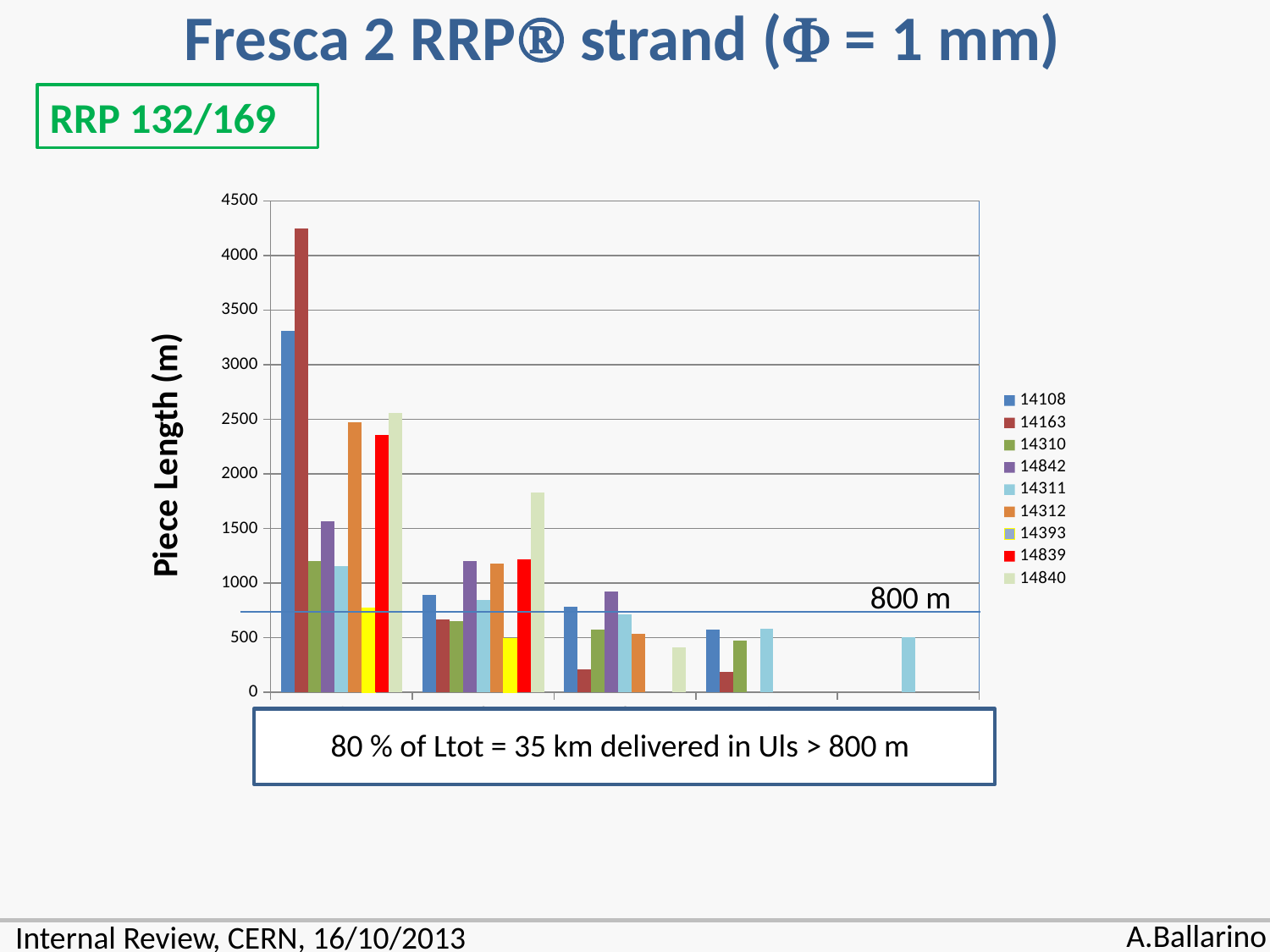
In the leftmost group of bars, which is larger: the value for series 14163 or the value for series 14108? 14163 In the leftmost group of bars, is the value for series 14108 greater or less than 3000? greater What value is marked by the horizontal reference line drawn across the chart? 800 m What is the label of the vertical axis? Piece Length (m) In the leftmost group of bars, which series has the tallest bar? 14163 In the second group of bars from the left, is the value for series 14840 greater or less than 1500? greater In the leftmost group of bars, is the value for series 14163 greater or less than 4000? greater What kind of chart is shown on the slide? bar chart How many series does the legend list? 9 In the leftmost group of bars, which is larger: the value for series 14840 or the value for series 14842? 14840